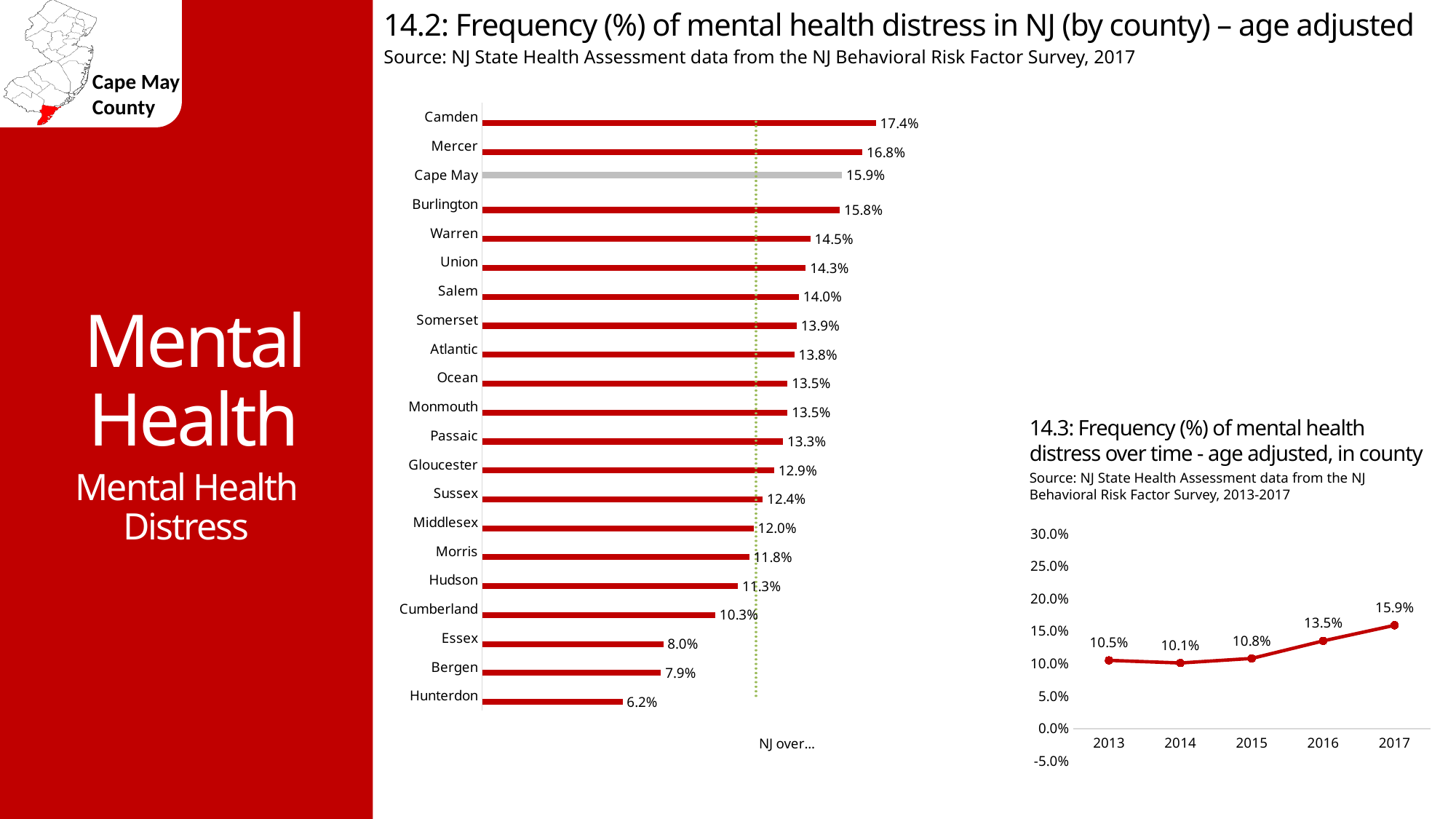
In the chart '14.2: Frequency (%) of mental health distress in NJ (by county) – age adjusted', what is the value for Cape May? 15.9% In the chart '14.2: Frequency (%) of mental health distress in NJ (by county) – age adjusted', what is the difference between Camden and Hunterdon? 11.2% In the chart '14.2: Frequency (%) of mental health distress in NJ (by county) – age adjusted', which county has the highest value? Camden In the chart '14.3: Frequency (%) of mental health distress over time - age adjusted, in county', what is the difference between 2017 and 2013? 5.4% In the chart '14.3: Frequency (%) of mental health distress over time - age adjusted, in county', what is the value for 2016? 13.5% In the chart '14.2: Frequency (%) of mental health distress in NJ (by county) – age adjusted', which county has the lowest value? Hunterdon What kind of chart is '14.3: Frequency (%) of mental health distress over time - age adjusted, in county'? Line chart How many counties are shown in the chart '14.2: Frequency (%) of mental health distress in NJ (by county) – age adjusted'? 21 In the chart '14.2: Frequency (%) of mental health distress in NJ (by county) – age adjusted', which is larger, Mercer or Burlington? Mercer What kind of chart is '14.2: Frequency (%) of mental health distress in NJ (by county) – age adjusted'? Bar chart In the chart '14.3: Frequency (%) of mental health distress over time - age adjusted, in county', which year has the lowest value? 2014 In the chart '14.2: Frequency (%) of mental health distress in NJ (by county) – age adjusted', what is the value for Cumberland? 10.3%